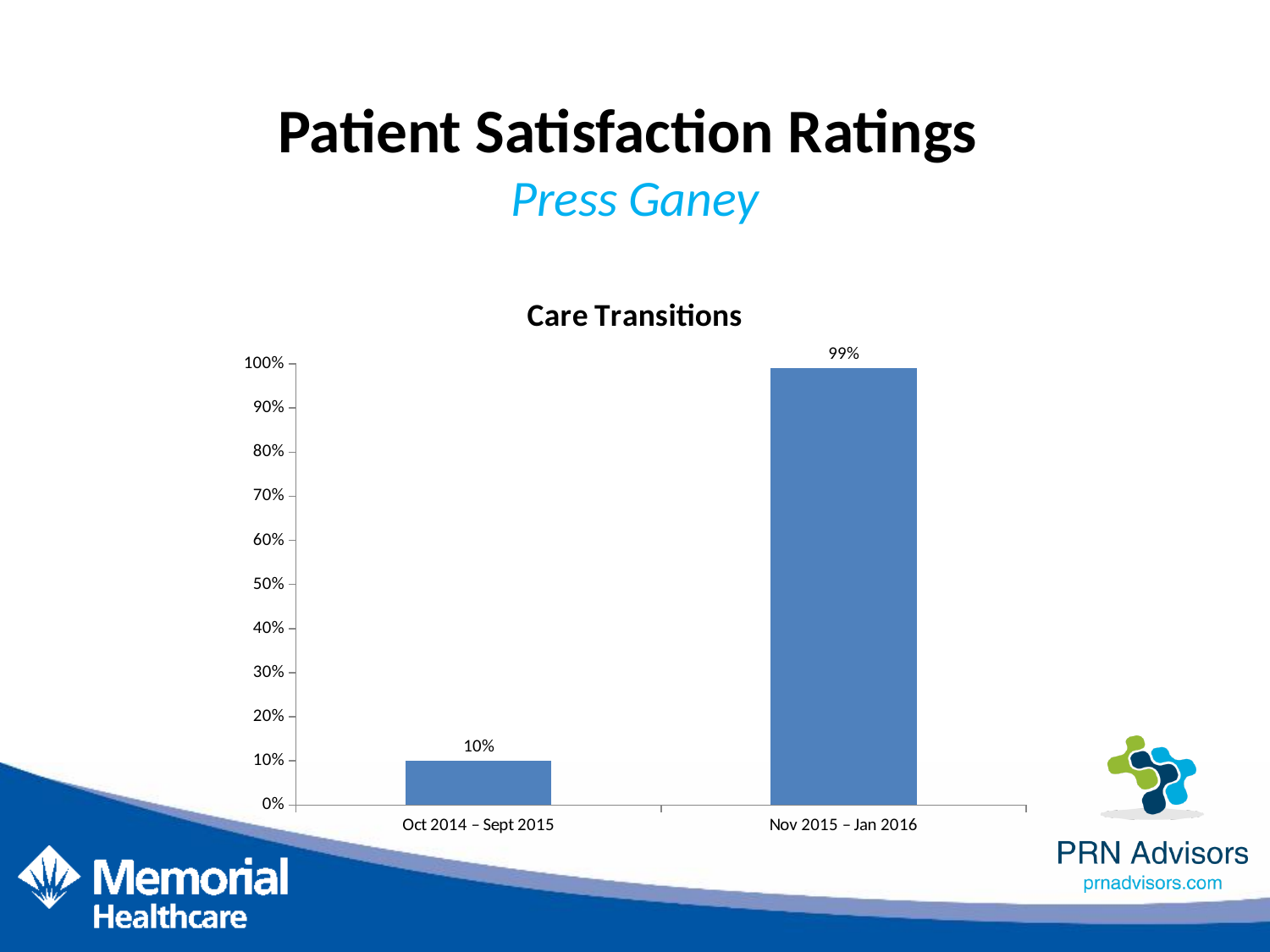
Which is larger, the value for Oct 2014 – Sept 2015 or the value for Nov 2015 – Jan 2016? Nov 2015 – Jan 2016 Is the value for Oct 2014 – Sept 2015 greater or less than 20%? less Which period has the highest value? Nov 2015 – Jan 2016 What is the title of the chart? Care Transitions Do the values rise or fall from the first period to the second? Rise How many categories are shown on the x axis? 2 What kind of chart is shown on the slide? Bar chart What is the value for Oct 2014 – Sept 2015? 10% Is the value for Nov 2015 – Jan 2016 greater or less than 90%? greater Which period has the lowest value? Oct 2014 – Sept 2015 What is the value for Nov 2015 – Jan 2016? 99% What is the difference between the Nov 2015 – Jan 2016 value and the Oct 2014 – Sept 2015 value? 89%